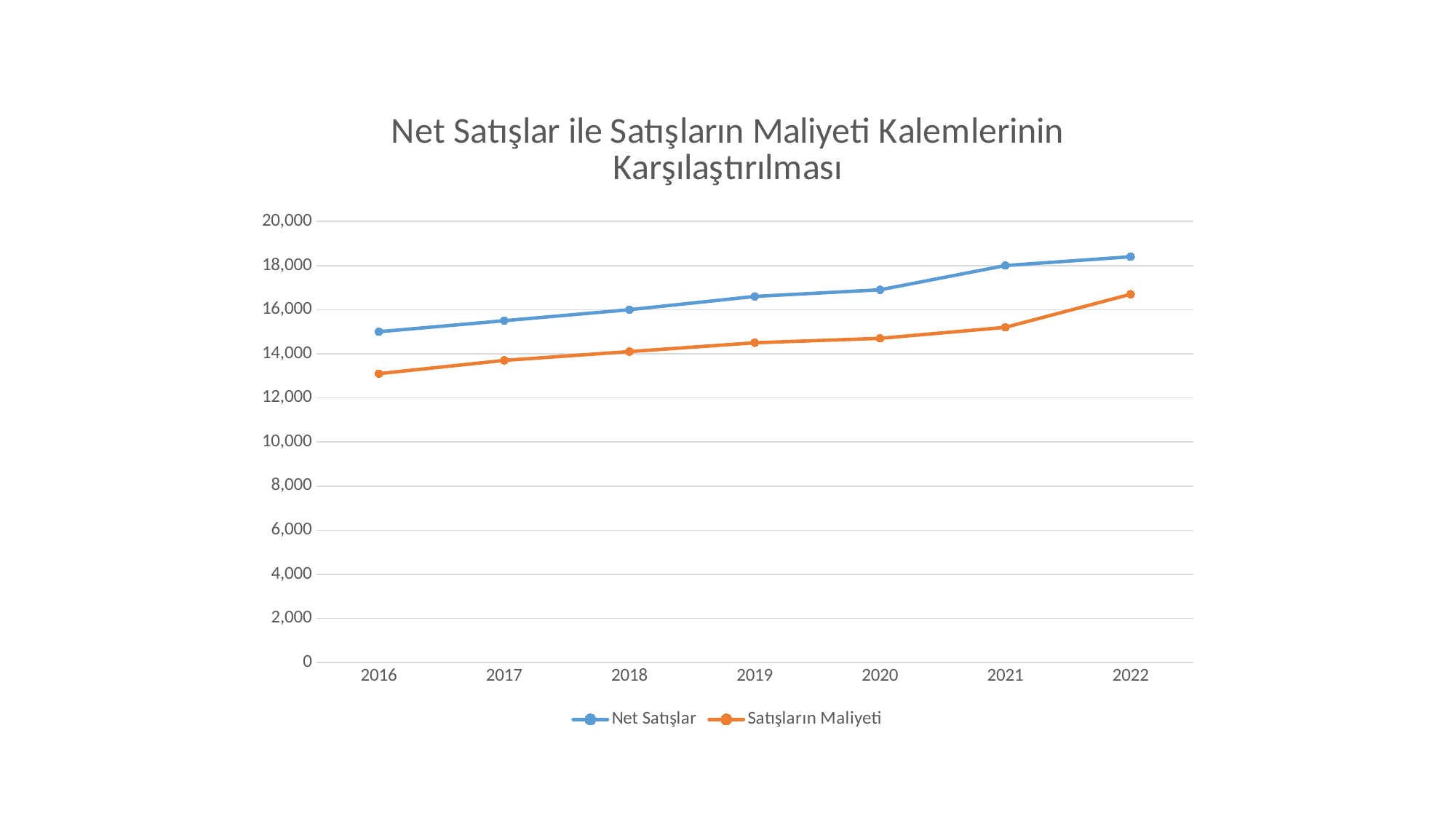
Is the value for Satışların Maliyeti in 2016 greater or less than 14,000? less How many years are plotted along the x axis? 7 Do the Net Satışlar values rise or fall from 2016 to 2022? rise What colour is the line for Satışların Maliyeti? Orange In which year is Satışların Maliyeti lowest? 2016 In which year is Net Satışlar highest? 2022 What kind of chart is shown on the slide? Line chart Is the value for Net Satışlar in 2016 greater or less than 14,000? greater Which series is higher in 2016, Net Satışlar or Satışların Maliyeti? Net Satışlar Is the value for Net Satışlar in 2022 greater or less than 20,000? less How many series does the legend list? 2